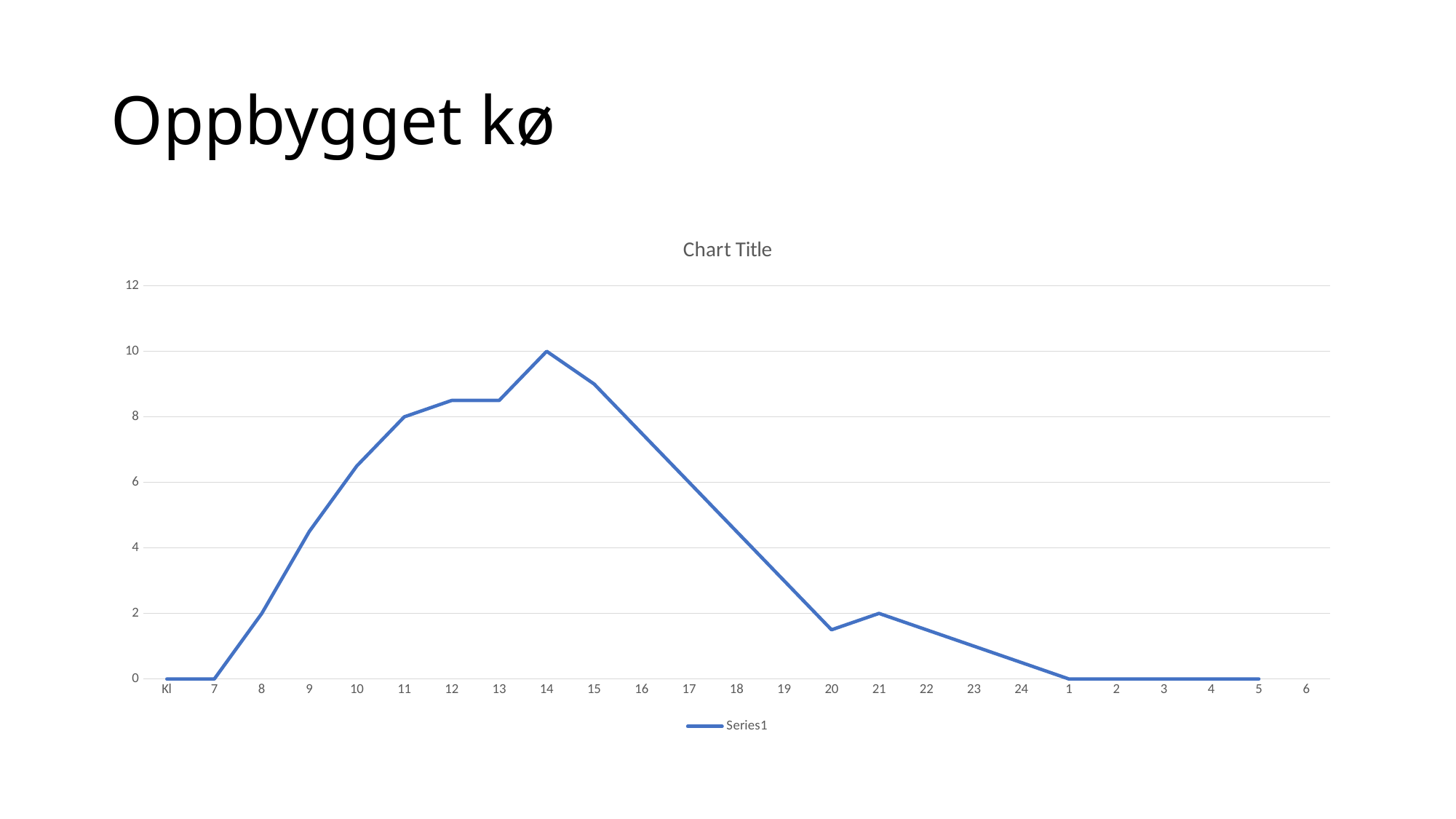
What is the difference between the value at 14 and the value at 11? 2 Is the value at 10 greater or less than 6? greater What is the value at 14? 10 What type of chart is shown on the slide? line chart Which is larger, the value at 15 or the value at 18? 15 What is the value at 11? 8 Does the line rise or fall between 14 and 20 on the x axis? fall How many series does the legend list? 1 What is the value at 7? 0 At which x-axis category does the line reach its highest value? 14 What is the value at 21? 2 Is the value at 22 greater or less than 2? less